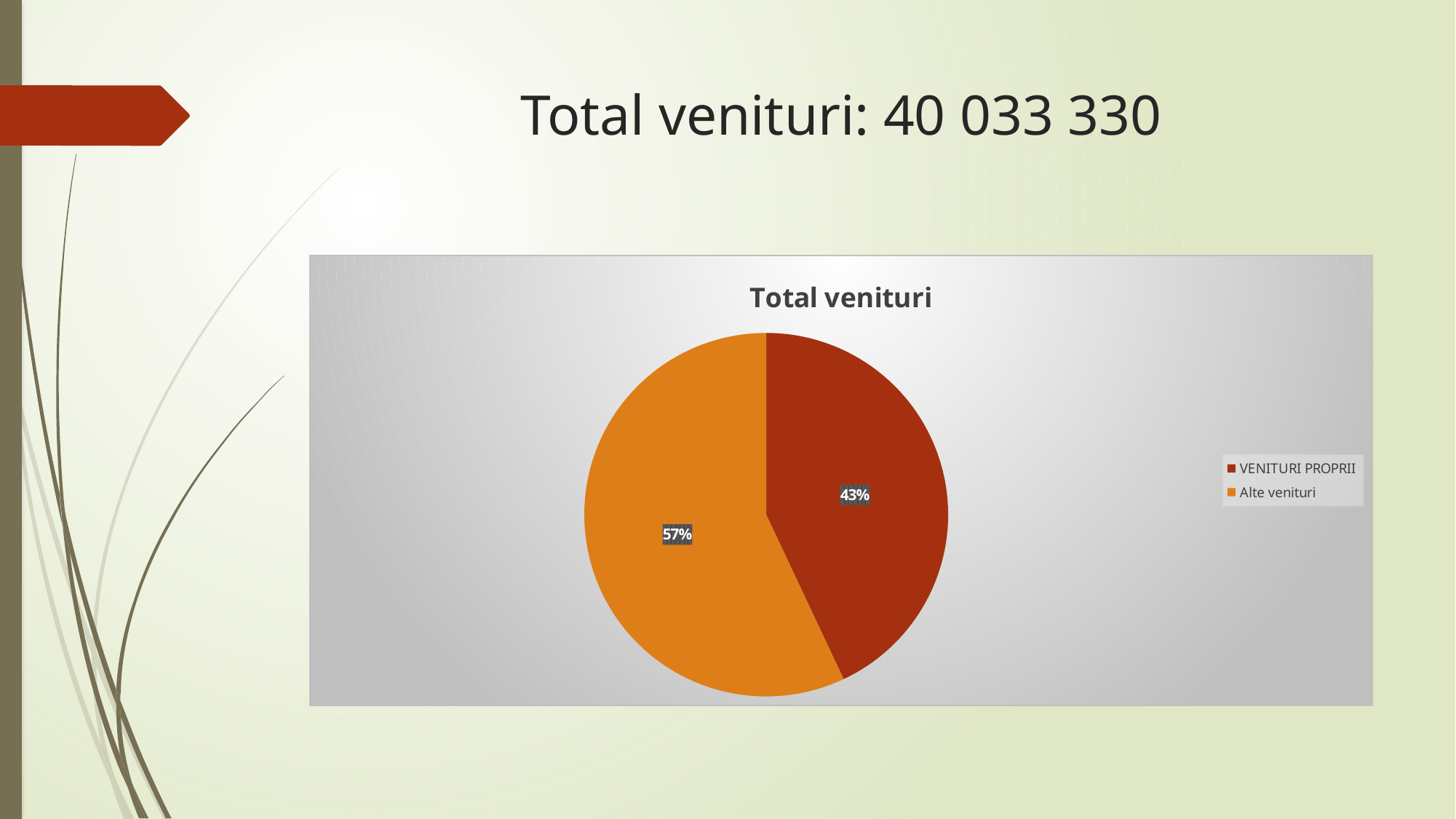
How many entries does the legend list? 2 What is the difference in percentage points between Alte venituri and VENITURI PROPRII? 14 How many slices does the pie chart have? 2 Which colour represents Alte venituri in the chart? orange Which slice is the smallest? VENITURI PROPRII What share of the pie does Alte venituri take? 57% What share of the pie does VENITURI PROPRII take? 43% What is the title of the chart? Total venituri Is the share for VENITURI PROPRII greater or less than 50%? less Which is larger, VENITURI PROPRII or Alte venituri? Alte venituri What kind of chart is shown on the slide? pie chart Which slice is the largest? Alte venituri